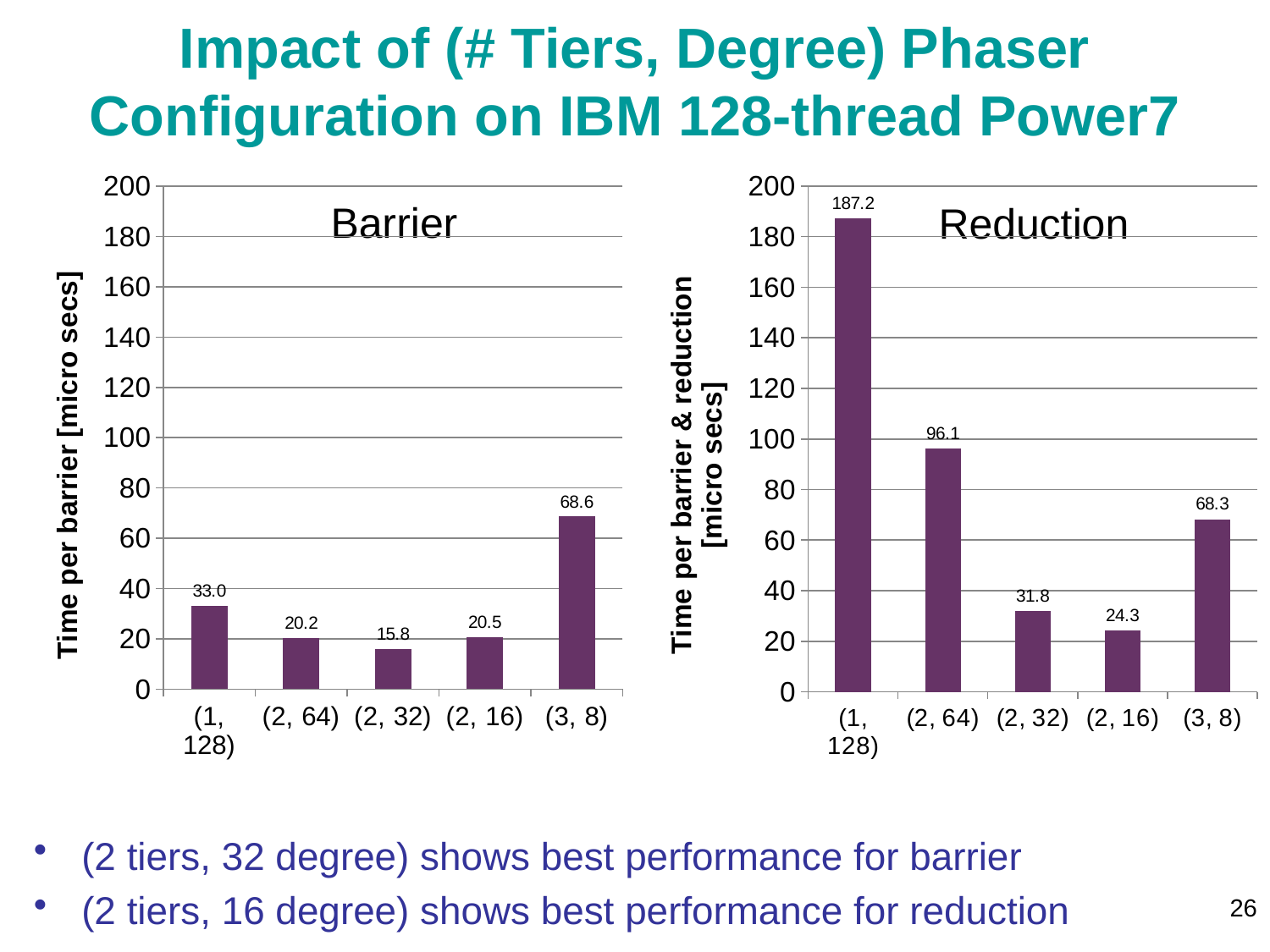
In the Barrier chart, which is larger: the value for (1, 128) or the value for (2, 64)? (1, 128) In the Reduction chart, is the value for (2, 64) greater or less than 80? greater In the Reduction chart, what is the value for the (3, 8) configuration? 68.3 In the Reduction chart, which configuration has the lowest time? (2, 16) In the Reduction chart, what is the difference between the values for (1, 128) and (2, 64)? 91.1 How many configurations are plotted in the Barrier chart? 5 In the Reduction chart, what is the value for the (1, 128) configuration? 187.2 In the Barrier chart, what is the time per barrier for the (2, 32) configuration? 15.8 What kind of chart is the Reduction chart? bar chart In the Barrier chart, which configuration has the highest time per barrier? (3, 8) In the Barrier chart, what is the difference between the values for (3, 8) and (2, 32)? 52.8 What is the y-axis label of the Barrier chart? Time per barrier [micro secs]